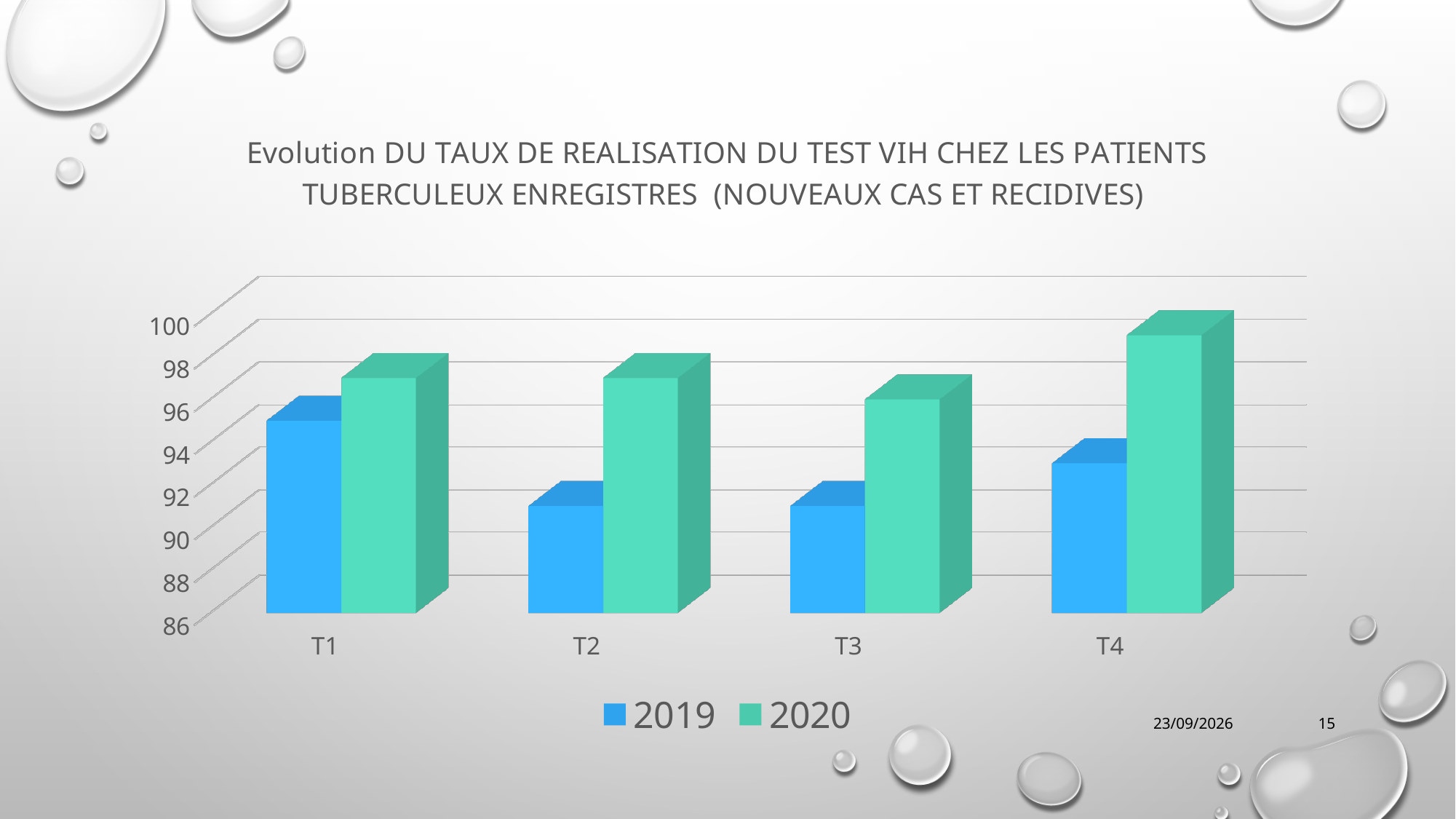
How many categories are shown on the x axis? 4 How many series does the legend list? 2 Is the 2020 value for T4 greater or less than 98? greater Which category has the highest value for the 2019 series? T1 Is the 2020 value for T3 greater or less than 94? greater What are the two series named in the legend? 2019 and 2020 What kind of chart is shown on the slide? bar chart For T4, which series has the larger value, 2019 or 2020? 2020 Which category has the highest value for the 2020 series? T4 Which series is larger at T2, 2019 or 2020? 2020 Is the 2019 value for T2 greater or less than 92? less